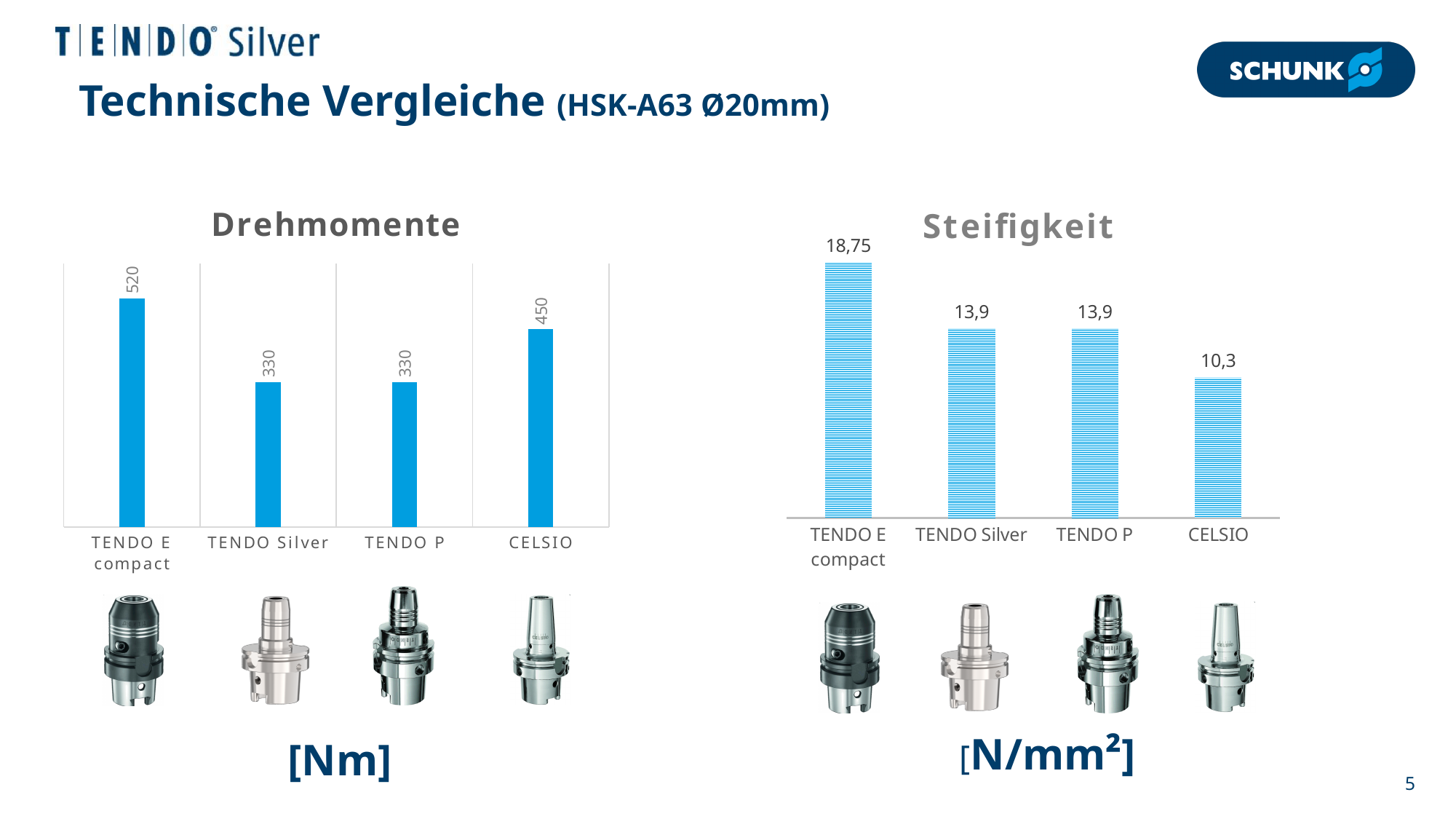
In the Steifigkeit chart, what is the difference between TENDO E compact and CELSIO? 8,45 In the Steifigkeit chart, which is larger, TENDO Silver or CELSIO? TENDO Silver What kind of chart is the Steifigkeit chart? Bar chart In the Steifigkeit chart, what is the value for CELSIO? 10,3 In the Steifigkeit chart, which category has the highest value? TENDO E compact In the Drehmomente chart, what is the value for CELSIO? 450 In the Drehmomente chart, which category has the lowest value? TENDO Silver and TENDO P (both 330) In the Drehmomente chart, how many categories are shown? 4 What unit is shown below the Drehmomente chart? [Nm] In the Drehmomente chart, what is the difference between TENDO E compact and CELSIO? 70 In the Steifigkeit chart, what is the value for TENDO E compact? 18,75 In the Drehmomente chart, what is the value for TENDO E compact? 520